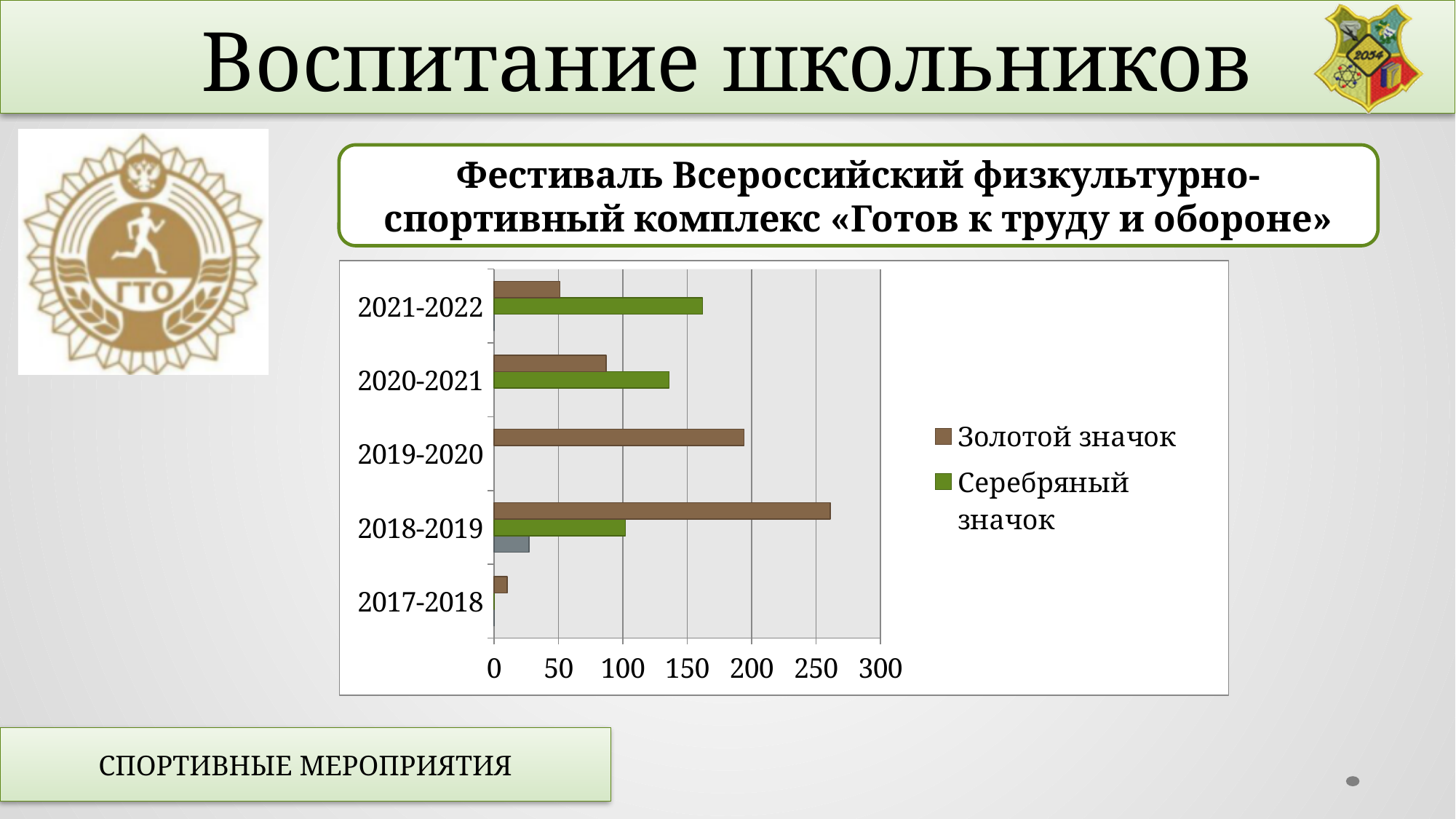
In which school year is the value for Золотой значок the highest? 2018-2019 Is the value for Серебряный значок in 2021-2022 greater or less than 150? greater Is the value for Золотой значок in 2020-2021 greater or less than 100? less What kind of chart is shown on the slide? bar chart How many series does the chart legend list? 2 Is the value for Золотой значок in 2019-2020 greater or less than 150? greater In 2018-2019, which is larger: Золотой значок or Серебряный значок? Золотой значок In which school year is the value for Золотой значок the lowest? 2017-2018 How many school-year categories are shown on the chart's vertical axis? 5 In 2021-2022, which is larger: Золотой значок or Серебряный значок? Серебряный значок Which series is shown in green in the chart legend? Серебряный значок